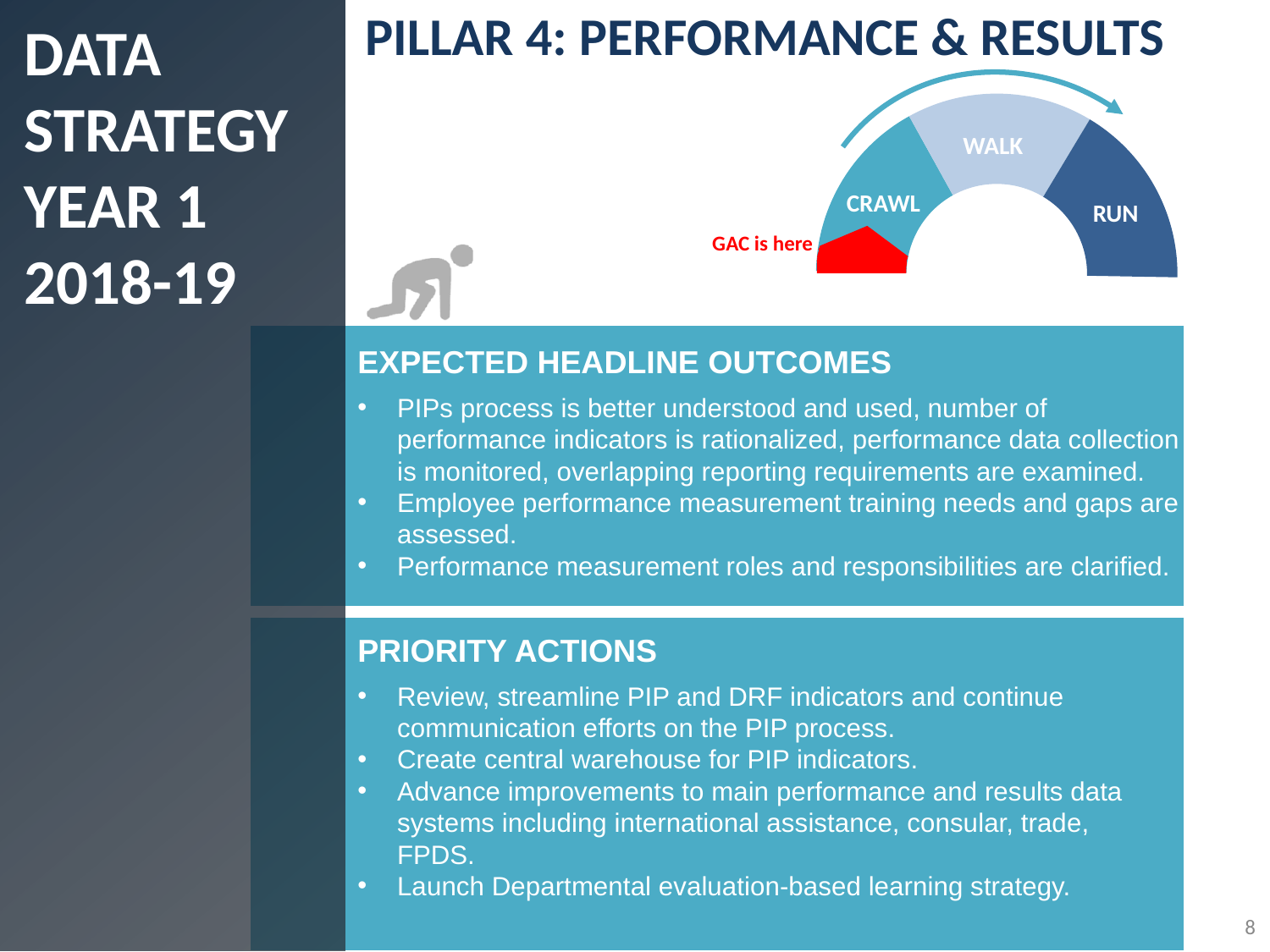
Which stage segment of the gauge chart is marked "GAC is here"? CRAWL What kind of chart is shown at the top right of the slide? gauge (doughnut) chart What is the label of the rightmost segment of the gauge chart? RUN What is the label of the middle segment of the gauge chart? WALK How many stage segments does the gauge chart show? 3